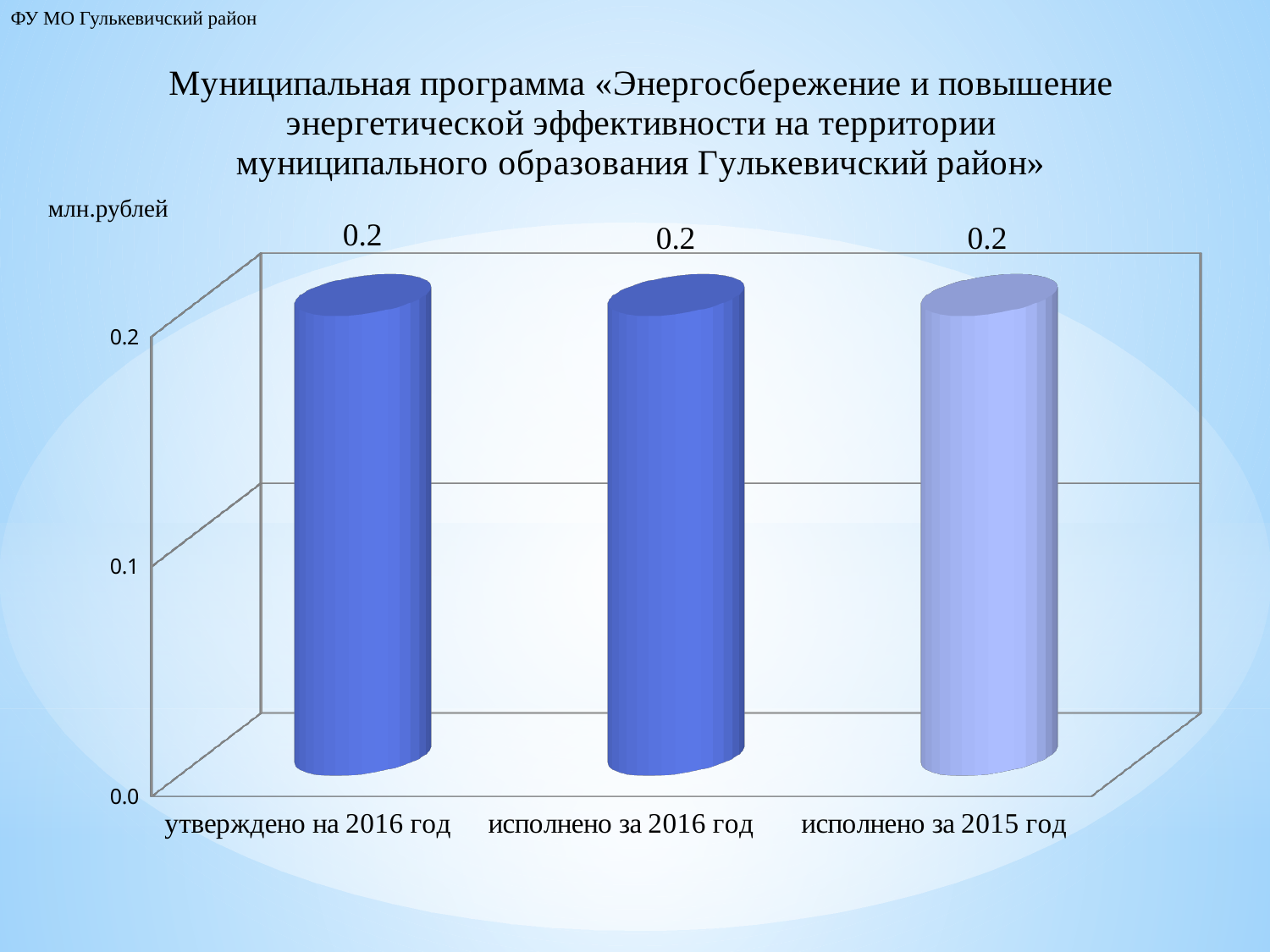
What is the value for «утверждено на 2016 год»? 0.2 Is the value for «исполнено за 2015 год» greater or less than 0.1? greater What is the value for «исполнено за 2015 год»? 0.2 What is the value for «исполнено за 2016 год»? 0.2 How many categories are shown in the chart? 3 What is the difference between the values for «исполнено за 2016 год» and «исполнено за 2015 год»? 0 What is the highest tick value shown on the vertical axis? 0.2 What is the difference between the values for «утверждено на 2016 год» and «исполнено за 2016 год»? 0 What kind of chart is shown on the slide? bar chart Do the values rise, fall or stay the same across the categories from left to right? stay the same What unit of measurement is indicated for the chart values? млн.рублей Is the value for «утверждено на 2016 год» greater or less than 0.1? greater